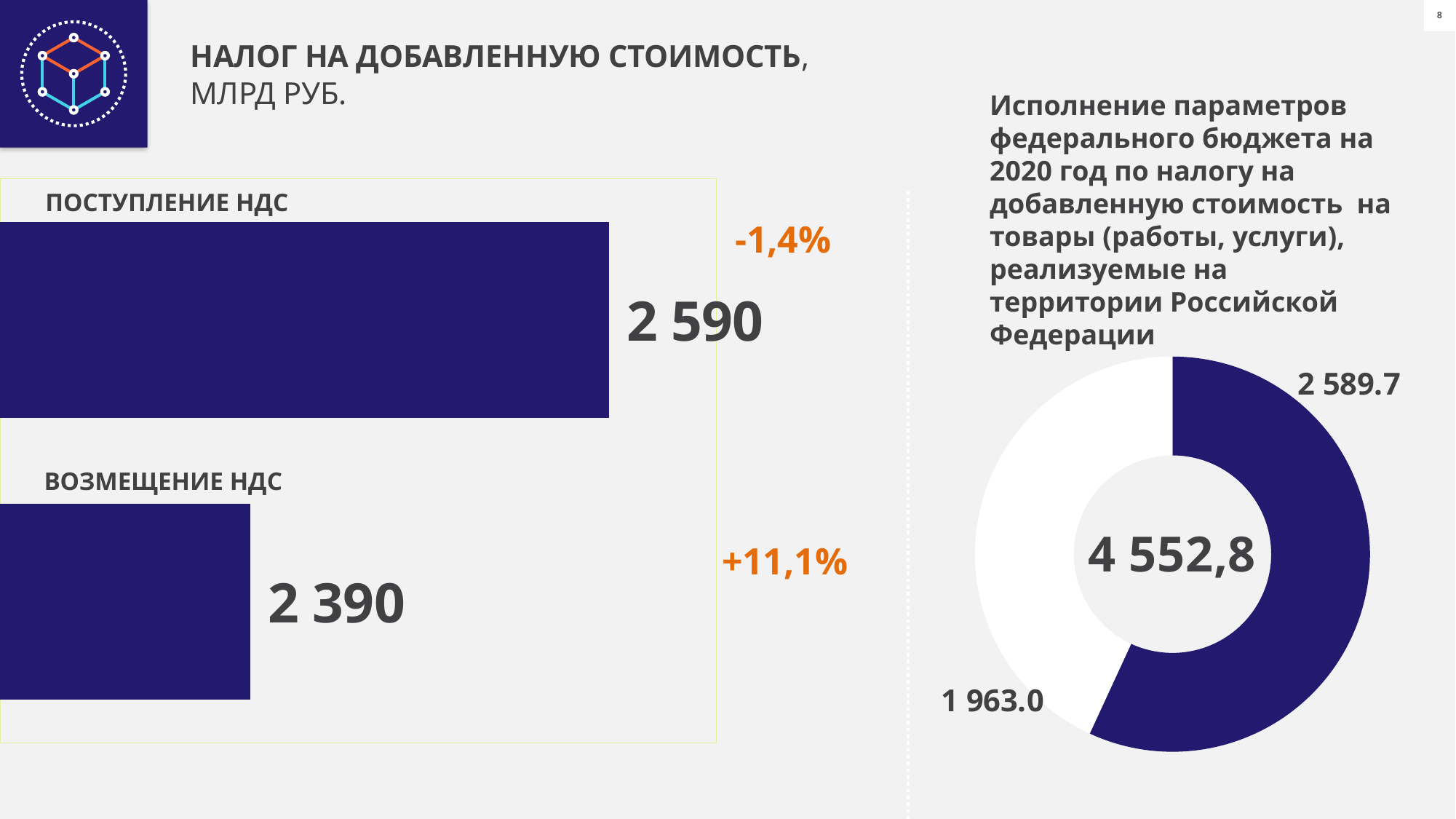
On the right doughnut chart, what value is labelled on the white segment? 1 963.0 On the left bar chart, which category has the higher value? ПОСТУПЛЕНИЕ НДС On the left bar chart, what percentage change is shown next to ПОСТУПЛЕНИЕ НДС? -1,4% How many bars does the left bar chart have? 2 On the left bar chart, what is the difference between ПОСТУПЛЕНИЕ НДС and ВОЗМЕЩЕНИЕ НДС? 200 On the right doughnut chart, what number is shown in the centre? 4 552,8 What kind of chart is shown on the right side of the slide? Doughnut chart On the left bar chart, what is the value for ВОЗМЕЩЕНИЕ НДС? 2 390 On the right doughnut chart, what value is labelled on the dark blue segment? 2 589.7 What kind of chart is shown on the left side of the slide? Bar chart On the left bar chart, what percentage change is shown next to ВОЗМЕЩЕНИЕ НДС? +11,1% On the left bar chart, what is the value for ПОСТУПЛЕНИЕ НДС? 2 590